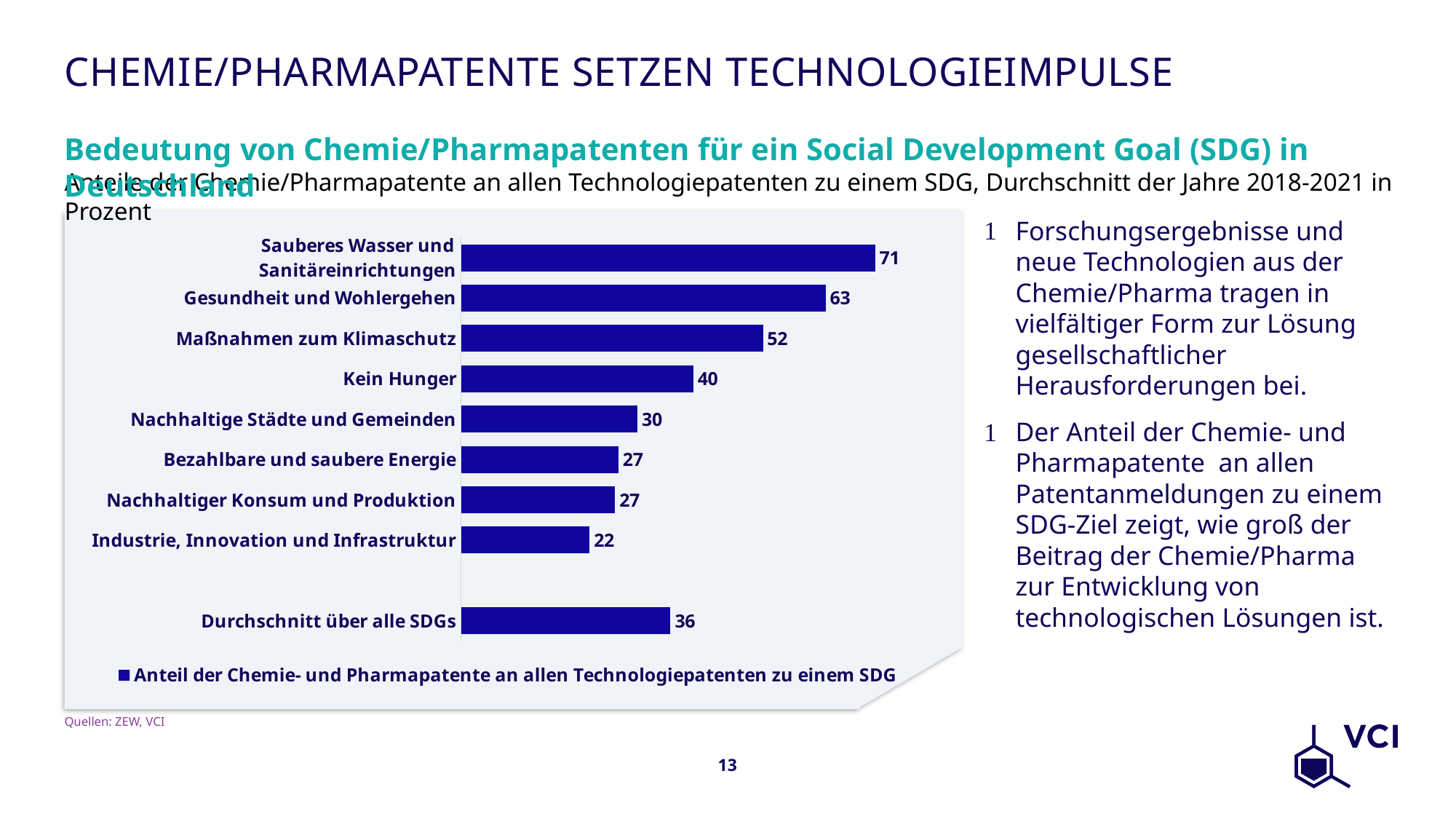
Which category has the lowest value? Industrie, Innovation und Infrastruktur What is the difference between the values for Gesundheit und Wohlergehen and Maßnahmen zum Klimaschutz? 11 What is the legend entry of the chart? Anteil der Chemie- und Pharmapatente an allen Technologiepatenten zu einem SDG Which is larger, the value for Nachhaltige Städte und Gemeinden or the value for Bezahlbare und saubere Energie? Nachhaltige Städte und Gemeinden What kind of chart is shown on the slide? Bar chart What is the value for Sauberes Wasser und Sanitäreinrichtungen? 71 What is the value for Industrie, Innovation und Infrastruktur? 22 What is the value for Durchschnitt über alle SDGs? 36 How many bars are shown in the chart? 9 What is the value for Kein Hunger? 40 Which category has the highest value? Sauberes Wasser und Sanitäreinrichtungen How many series does the legend list? 1